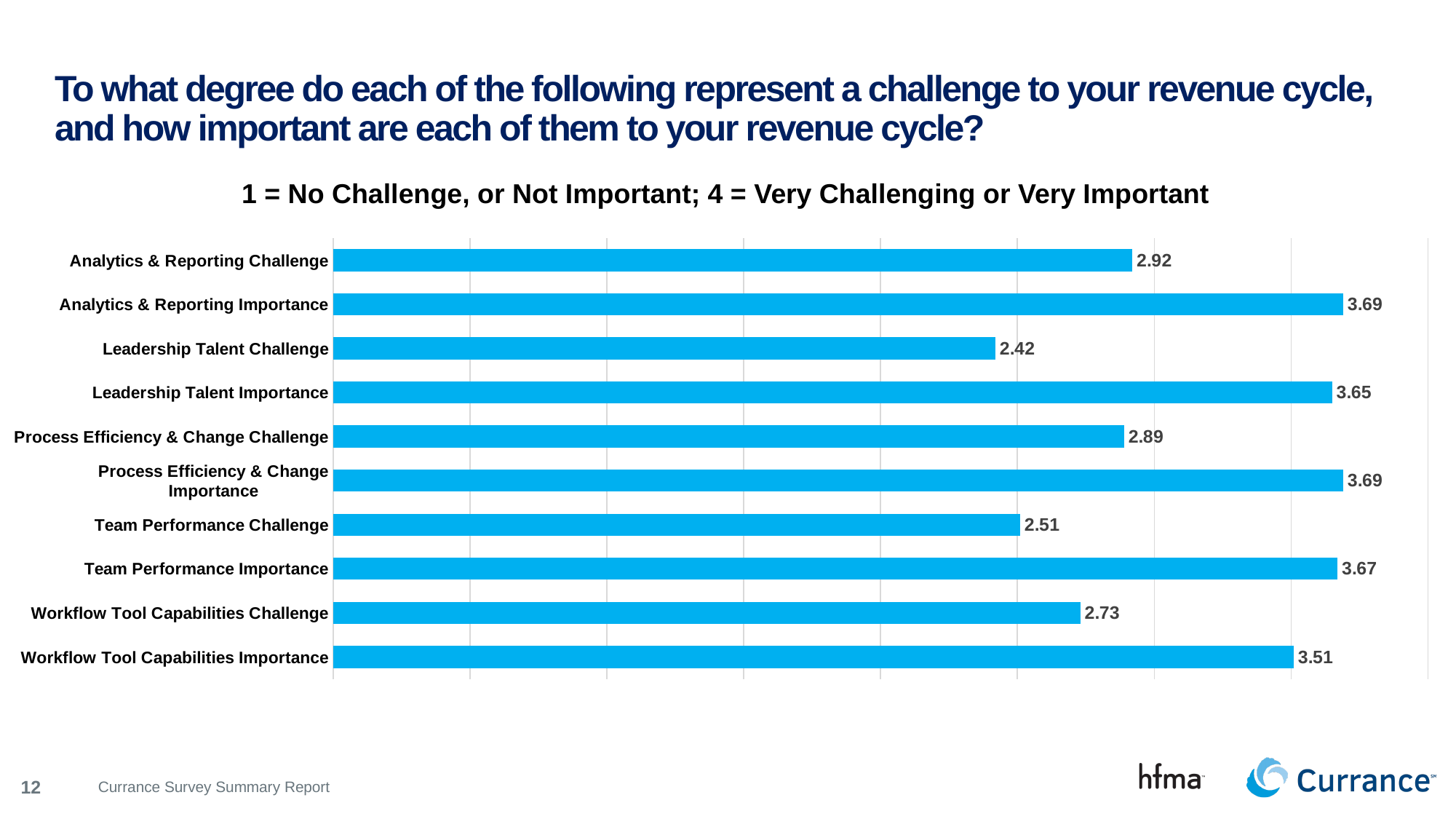
What kind of chart is shown on the slide? Bar chart What is the value for Leadership Talent Importance? 3.65 Which is larger, Workflow Tool Capabilities Challenge or Process Efficiency & Change Challenge? Process Efficiency & Change Challenge Which category has the lowest value? Leadership Talent Challenge What is the value for Analytics & Reporting Challenge? 2.92 What is the value for Team Performance Challenge? 2.51 Which is larger, Leadership Talent Challenge or Team Performance Challenge? Team Performance Challenge What is the difference between Team Performance Importance and Team Performance Challenge? 1.16 How many categories are shown in the chart? 10 What is the value for Workflow Tool Capabilities Importance? 3.51 According to the chart subtitle, what does a score of 4 represent? Very Challenging or Very Important What is the difference between Analytics & Reporting Importance and Analytics & Reporting Challenge? 0.77